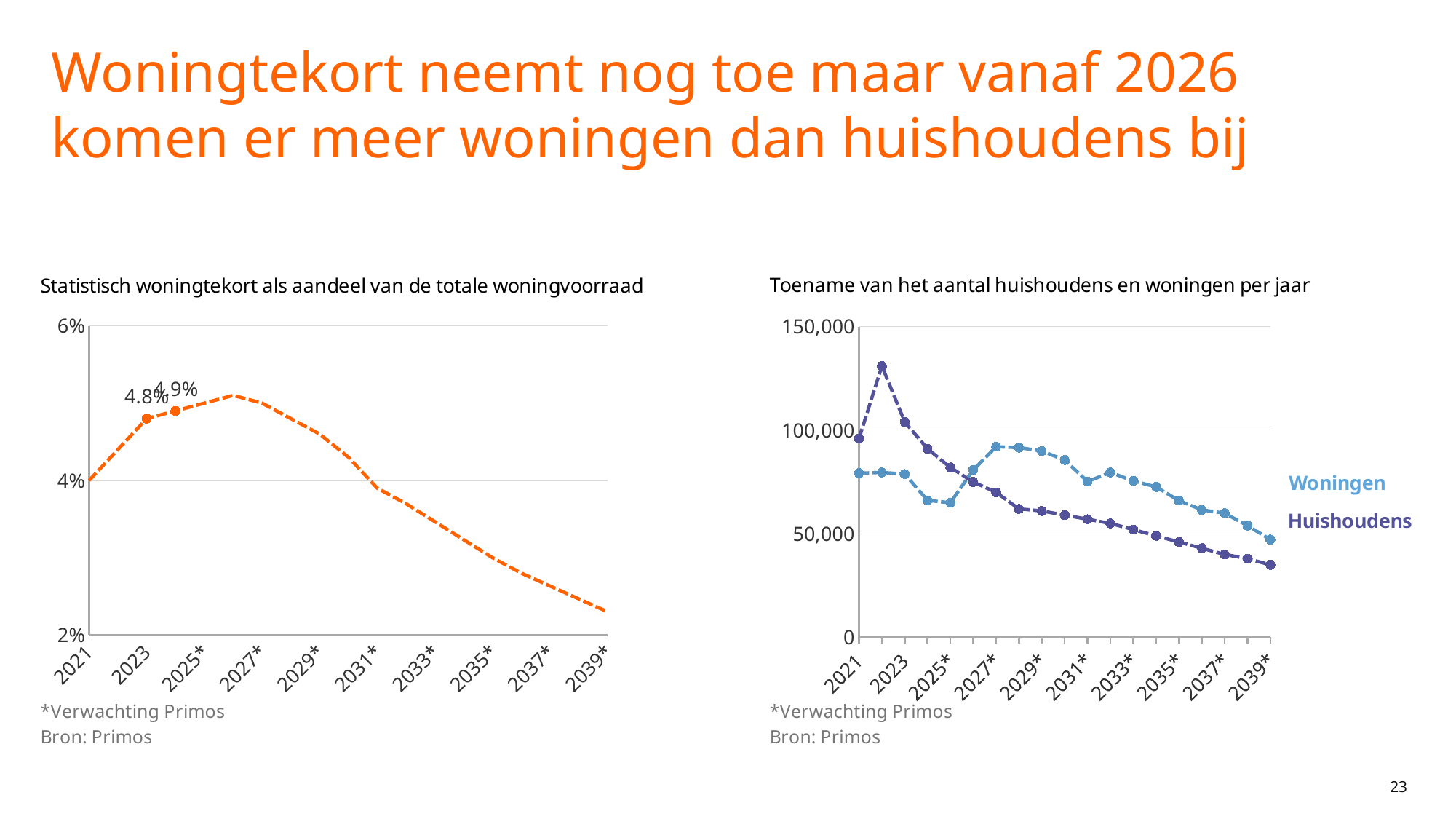
In the right chart, 'Toename van het aantal huishoudens en woningen per jaar', which series has the larger value in 2028*, Woningen or Huishoudens? Woningen In the right chart, 'Toename van het aantal huishoudens en woningen per jaar', which series is drawn in light blue? Woningen How many series does the legend of the right chart, 'Toename van het aantal huishoudens en woningen per jaar', list? 2 What kind of chart is the left chart, 'Statistisch woningtekort als aandeel van de totale woningvoorraad'? line chart In the left chart, 'Statistisch woningtekort als aandeel van de totale woningvoorraad', what is the value for 2023? 4.8% In the left chart, 'Statistisch woningtekort als aandeel van de totale woningvoorraad', what is the difference between the 2024 value and the 2023 value? 0.1% In the left chart, 'Statistisch woningtekort als aandeel van de totale woningvoorraad', do the values rise or fall from 2027* to 2039*? fall In the right chart, 'Toename van het aantal huishoudens en woningen per jaar', is the Huishoudens value for 2039* greater or less than 50,000? less In the left chart, 'Statistisch woningtekort als aandeel van de totale woningvoorraad', is the value for 2039* greater or less than 4%? less In the left chart, 'Statistisch woningtekort als aandeel van de totale woningvoorraad', what is the value for 2024? 4.9% In the right chart, 'Toename van het aantal huishoudens en woningen per jaar', in which year does the Huishoudens series reach its highest value? 2022 In the right chart, 'Toename van het aantal huishoudens en woningen per jaar', is the Huishoudens value for 2022 greater or less than 100,000? greater